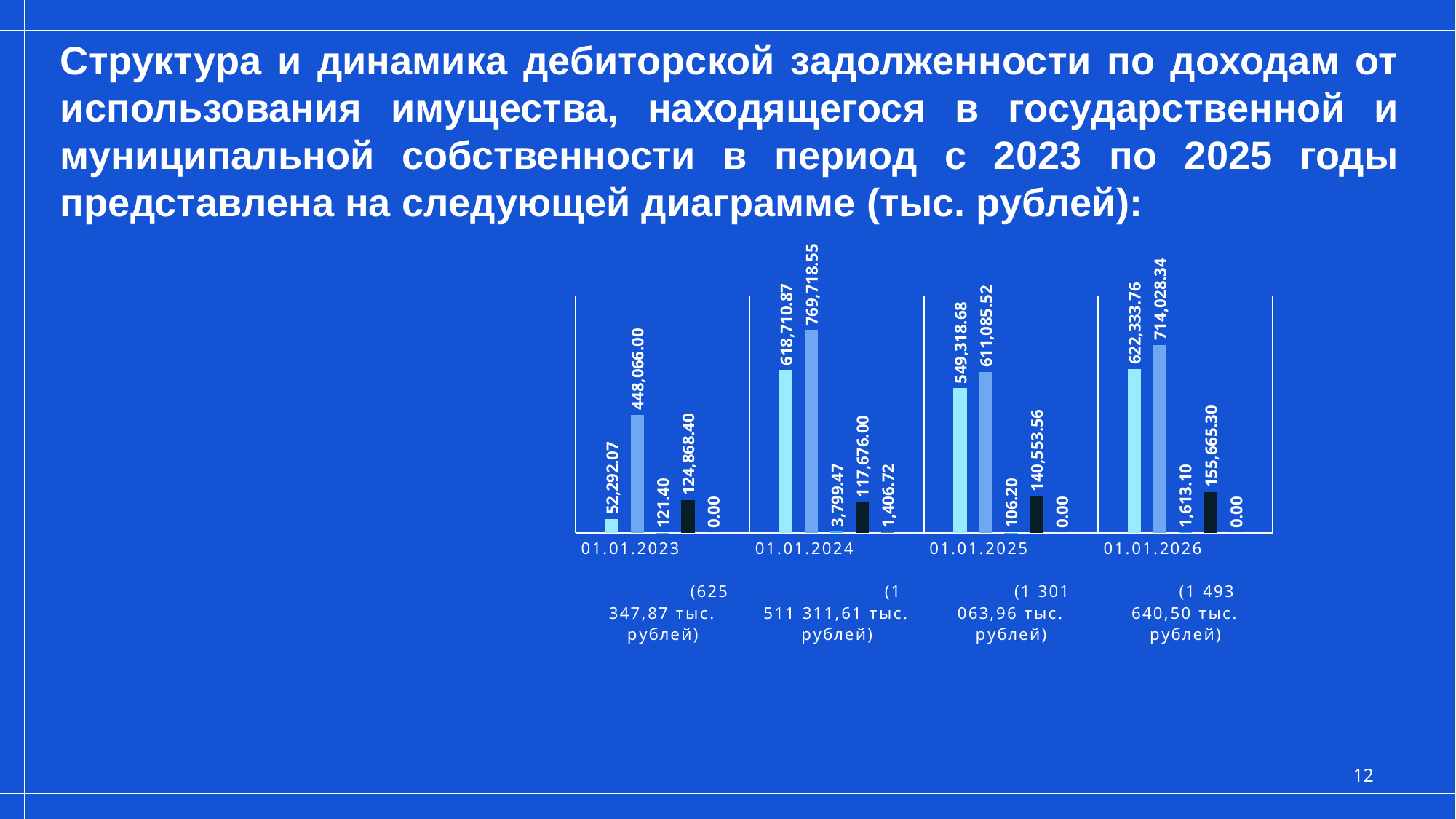
Which is larger for 01.01.2026: the first (light blue) bar or the second (medium blue) bar? the second (medium blue) bar How many bars are plotted for each date category in the chart? 5 What is the value of the first (light blue) bar for 01.01.2023? 52,292.07 What is the value of the second (medium blue) bar for 01.01.2024? 769,718.55 What is the difference between the second bar and the first bar for 01.01.2023? 395,773.93 What is the value of the black bar for 01.01.2026? 155,665.30 What is the value of the third bar for 01.01.2025? 106.20 How many date categories are shown on the x axis of the chart? 4 For which date is the black bar the lowest? 01.01.2024 What kind of chart is shown on the slide? bar chart For which date is the second (medium blue) bar the highest? 01.01.2024 What total is printed in parentheses under the 01.01.2025 category? 1 301 063,96 тыс. рублей